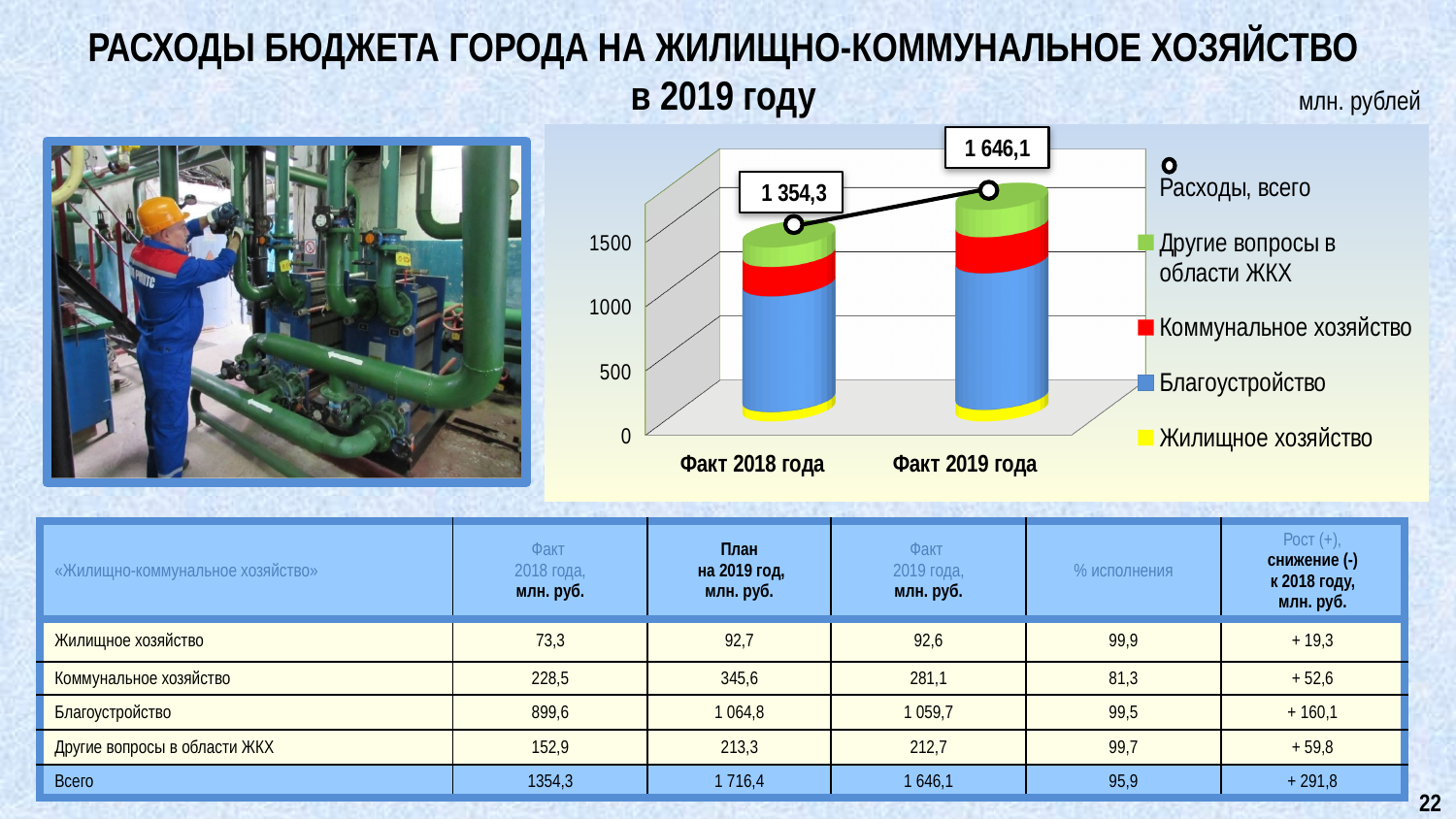
Is the total for 'Факт 2019 года' greater or less than 1500? greater Which legend entry is shown in yellow? Жилищное хозяйство Which category has the higher total expenditure, 'Факт 2018 года' or 'Факт 2019 года'? Факт 2019 года How many entries does the chart legend list? 5 Is the total for 'Факт 2018 года' greater or less than 1500? less What is the value of the 'Расходы, всего' line for 'Факт 2018 года'? 1 354,3 Does the total expenditure rise or fall from 'Факт 2018 года' to 'Факт 2019 года'? rise By how much does the total for 'Факт 2019 года' exceed the total for 'Факт 2018 года'? 291,8 Which legend entry is shown in red? Коммунальное хозяйство What type of chart is shown on the slide? stacked bar chart with a line How many categories are shown on the x axis of the chart? 2 What is the value of the 'Расходы, всего' line for 'Факт 2019 года'? 1 646,1